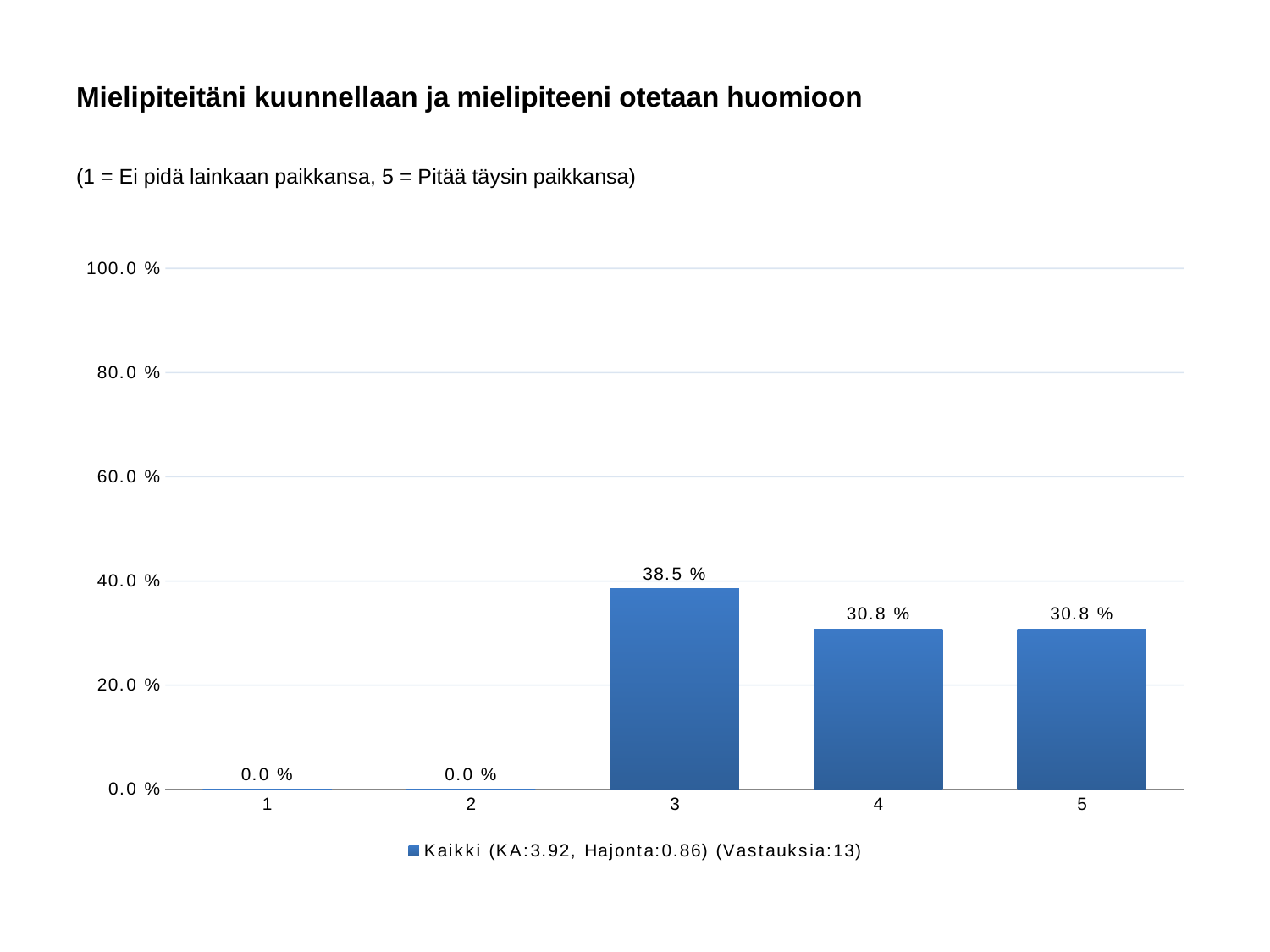
What is the title of the slide? Mielipiteitäni kuunnellaan ja mielipiteeni otetaan huomioon How many responses (Vastauksia) does the legend report? 13 What is the value for category 4? 30.8 % What is the difference between the values for category 3 and category 5? 7.7 % Which category has the highest value? 3 How many series does the legend list? 1 What kind of chart is shown on the slide? bar chart How many categories are shown on the x axis? 5 What is the value for category 1? 0.0 % Is the value for category 3 greater or less than 40.0 %? less Which is larger, the value for category 3 or the value for category 4? 3 What is the value for category 3? 38.5 %